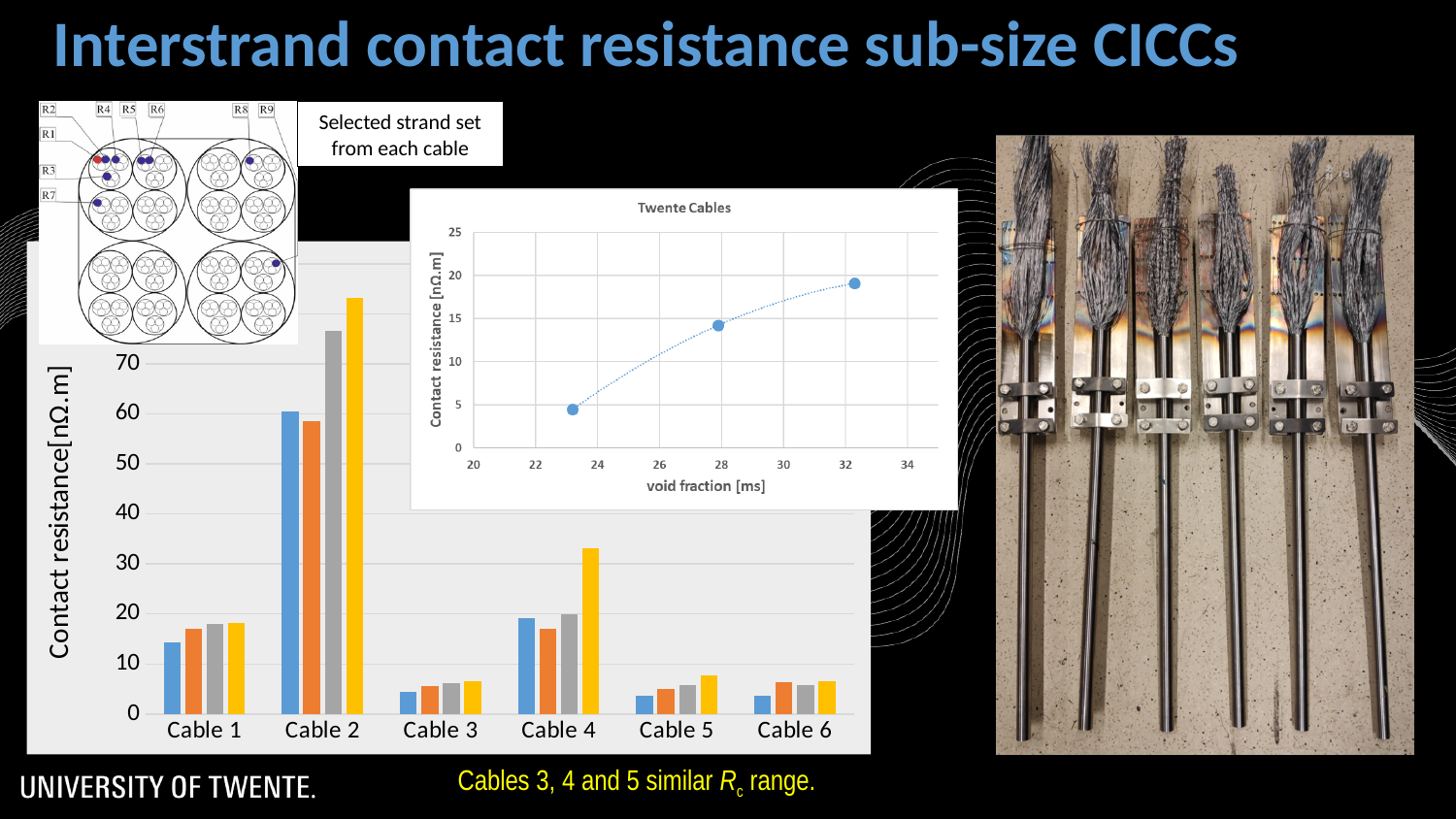
In the large bar chart, are all the bars for Cable 1 greater or less than 20 nΩ.m? less In the large bar chart, is the tallest bar for Cable 4 greater or less than 30 nΩ.m? greater In the 'Twente Cables' chart, does contact resistance rise or fall as void fraction increases? Rises In the large bar chart, are all the bars for Cable 3 greater or less than 10 nΩ.m? less What kind of chart is the large chart at the bottom left of the slide? Bar chart In the large bar chart at the bottom left, which cable has the highest contact resistance? Cable 2 In the large bar chart, which has the higher contact resistance overall, Cable 1 or Cable 3? Cable 1 In the large bar chart, which has the higher contact resistance overall, Cable 2 or Cable 4? Cable 2 How many data points are plotted in the 'Twente Cables' chart? 3 How many cable categories are shown on the x axis of the large bar chart? 6 What is the title of the small inset chart in the middle of the slide? Twente Cables